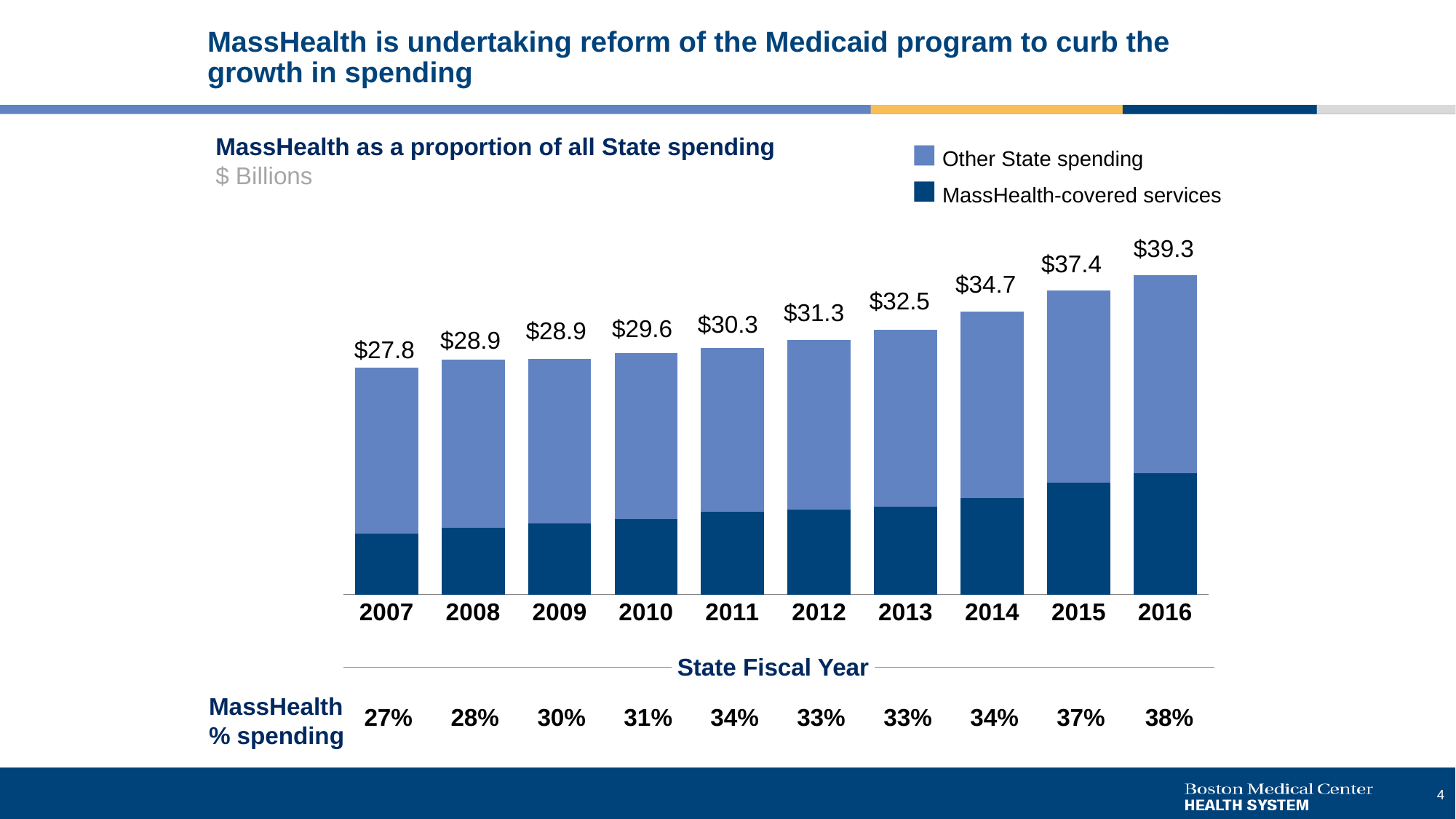
What is the MassHealth % spending shown for 2011? 34% Do the total State spending values rise or fall from 2007 to 2016? Rise Which year has the larger total State spending, 2014 or 2013? 2014 How many fiscal years are shown on the x axis? 10 What kind of chart is shown on the slide? Stacked bar chart Which fiscal year has the highest total State spending? 2016 What is the total State spending shown for 2007? $27.8 What unit is the chart measured in, according to the subtitle? $ Billions What is the difference between the total State spending in 2016 and in 2007? $11.5 How many series does the legend list? 2 What is the total State spending shown for 2012? $31.3 Which fiscal year has the lowest total State spending? 2007